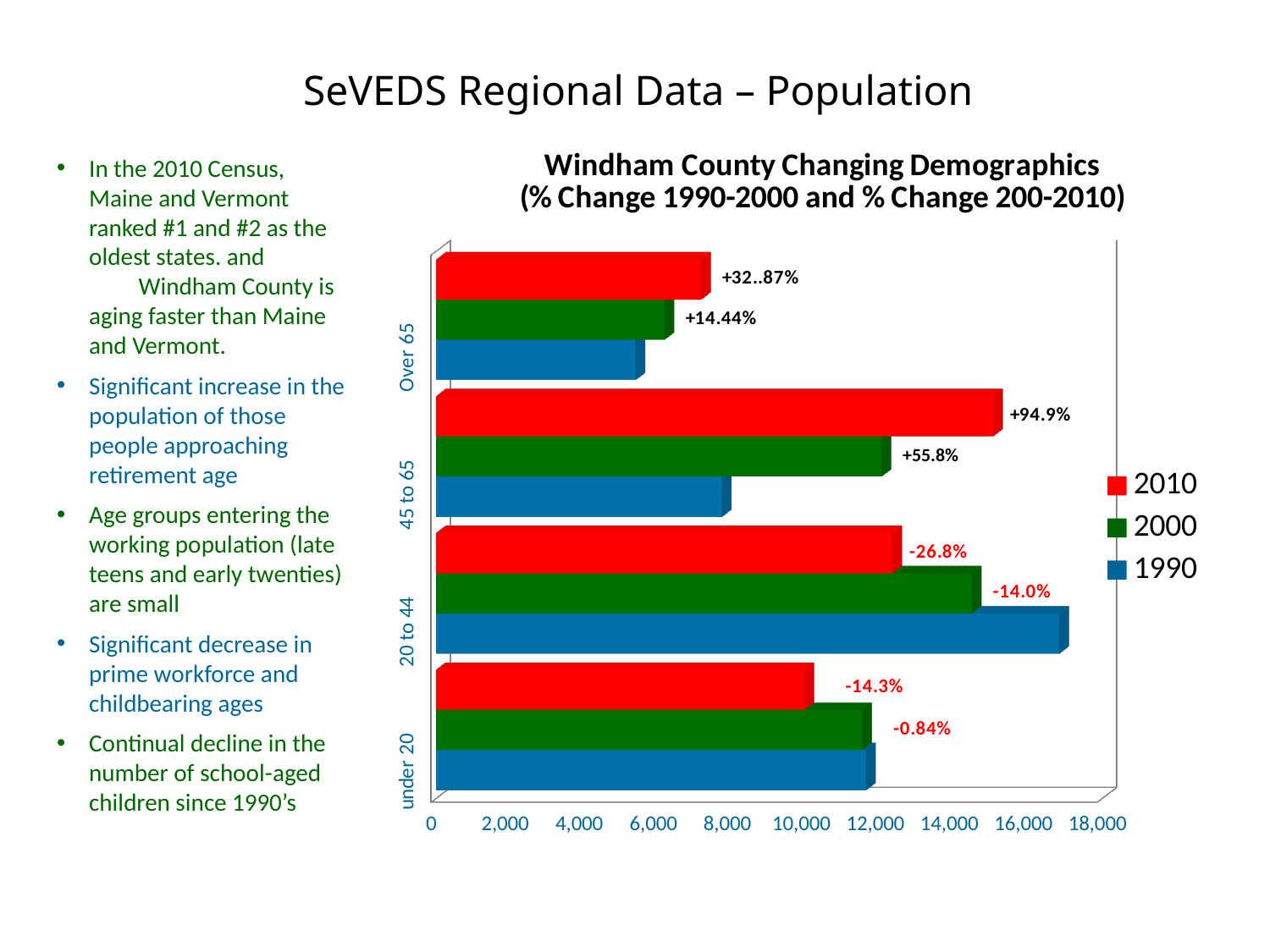
What is the title of the chart? Windham County Changing Demographics (% Change 1990-2000 and % Change 200-2010) How many series does the chart legend list? 3 Which age group has the shortest 1990 bar? Over 65 For the 45 to 65 age group, which is larger: the 2010 value or the 1990 value? 2010 Which age group has the longest 2010 bar? 45 to 65 Is the 1990 value for the Over 65 age group greater or less than 6,000? less Which age group has the longest 1990 bar? 20 to 44 Is the 2010 value for the 45 to 65 age group greater or less than 14,000? greater What percentage change label is printed next to the 2010 bar for the 45 to 65 age group? +94.9% How many age-group categories are shown on the chart? 4 What kind of chart is shown on the slide? Bar chart For the 20 to 44 age group, which is larger: the 1990 value or the 2010 value? 1990